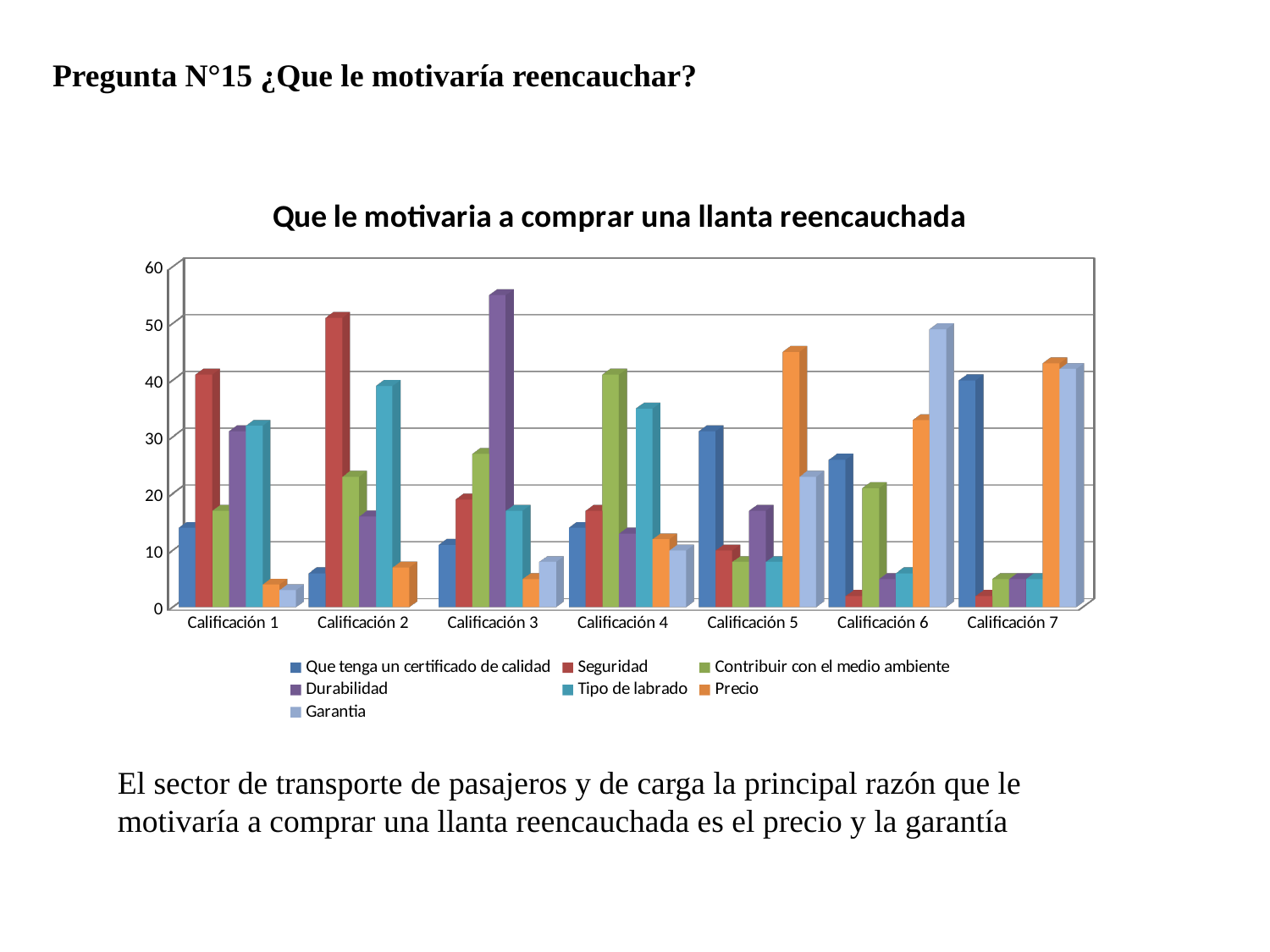
What is the title of the chart? Que le motivaria a comprar una llanta reencauchada In Calificación 1, which is larger: Seguridad or Durabilidad? Seguridad Is the value for Seguridad in Calificación 2 greater or less than 40? greater Is the value for Precio in Calificación 5 greater or less than 40? greater Is the value for Durabilidad in Calificación 3 greater or less than 50? greater How many series does the legend list? 7 How many categories (Calificación groups) are shown on the x axis? 7 Which series has the highest bar in Calificación 2? Seguridad Which series has the highest bar in Calificación 3? Durabilidad In Calificación 4, which is larger: Contribuir con el medio ambiente or Tipo de labrado? Contribuir con el medio ambiente What kind of chart is shown on the slide? bar chart Which series has the highest bar in Calificación 6? Garantia